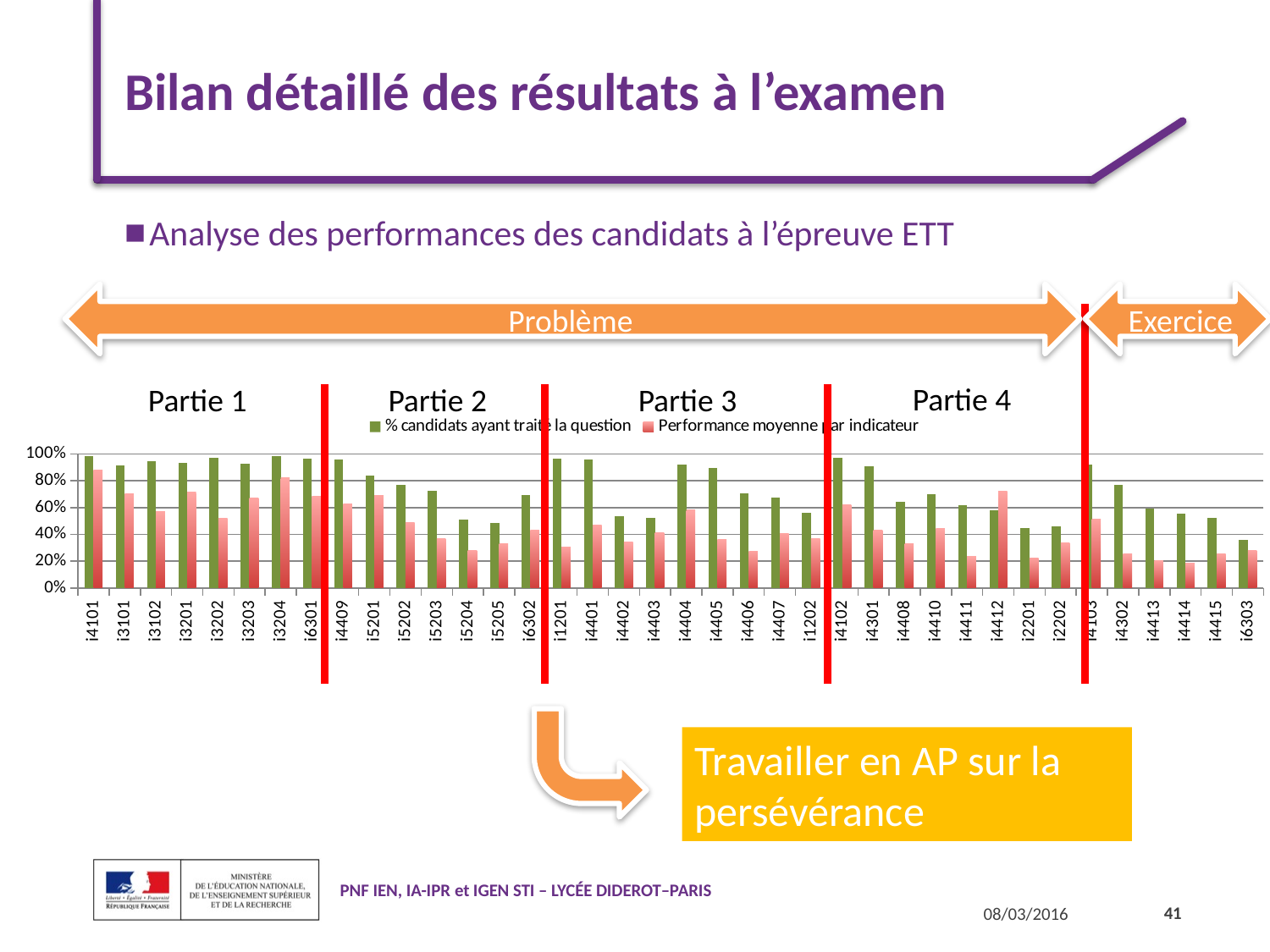
Is the value of '% candidats ayant traité la question' for i4101 greater or less than 80%? greater Which category has the highest value for 'Performance moyenne par indicateur'? i4101 Do the values of '% candidats ayant traité la question' generally rise or fall from left to right across the x axis? fall Is the value of 'Performance moyenne par indicateur' for i4412 greater or less than 60%? greater Which category has the lowest value for '% candidats ayant traité la question'? i6303 For i4101, which series has the larger value: '% candidats ayant traité la question' or 'Performance moyenne par indicateur'? % candidats ayant traité la question What kind of chart is shown on the slide? bar chart Is the value of '% candidats ayant traité la question' for i6303 greater or less than 40%? less How many series does the chart legend list? 2 How many indicator categories are plotted along the x axis of the chart? 38 What are the two series named in the chart legend? % candidats ayant traité la question; Performance moyenne par indicateur